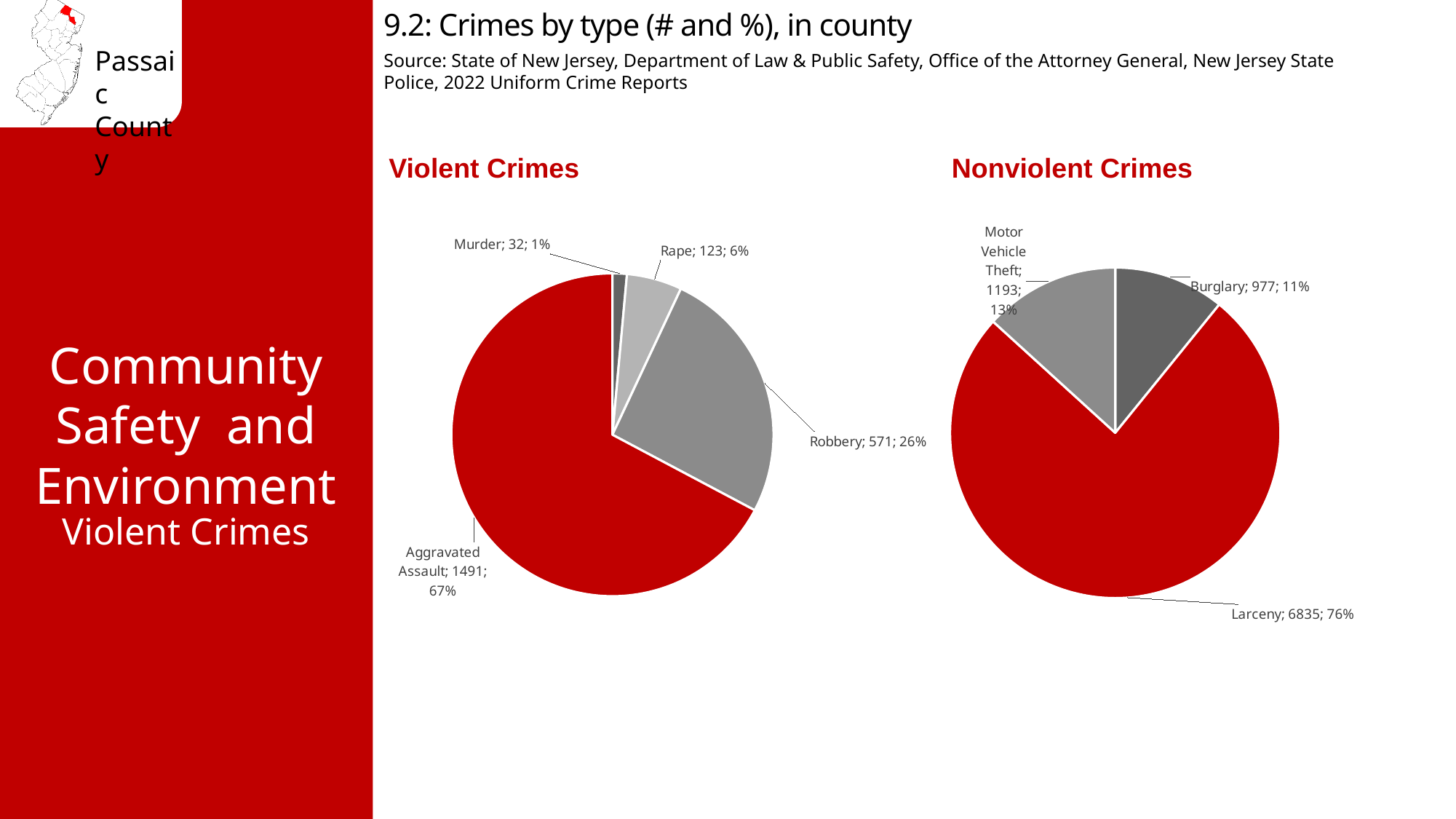
In the Violent Crimes chart, which category has the largest slice? Aggravated Assault In the Violent Crimes chart, which category has the smallest slice? Murder In the Nonviolent Crimes chart, how many larcenies are shown? 6835 What is the title of the slide's chart section? 9.2: Crimes by type (# and %), in county In the Nonviolent Crimes chart, what share of the pie is Motor Vehicle Theft? 13% In the Violent Crimes chart, how many aggravated assaults are shown? 1491 In the Violent Crimes chart, what share of the pie is Robbery? 26% In the Nonviolent Crimes chart, what is the difference between the number of motor vehicle thefts and burglaries? 216 In the Violent Crimes chart, what is the difference between the number of robberies and the number of rapes? 448 In the Nonviolent Crimes chart, which is larger, Burglary or Motor Vehicle Theft? Motor Vehicle Theft What kind of chart is the Nonviolent Crimes chart? Pie chart In the Violent Crimes chart, how many categories are shown? 4